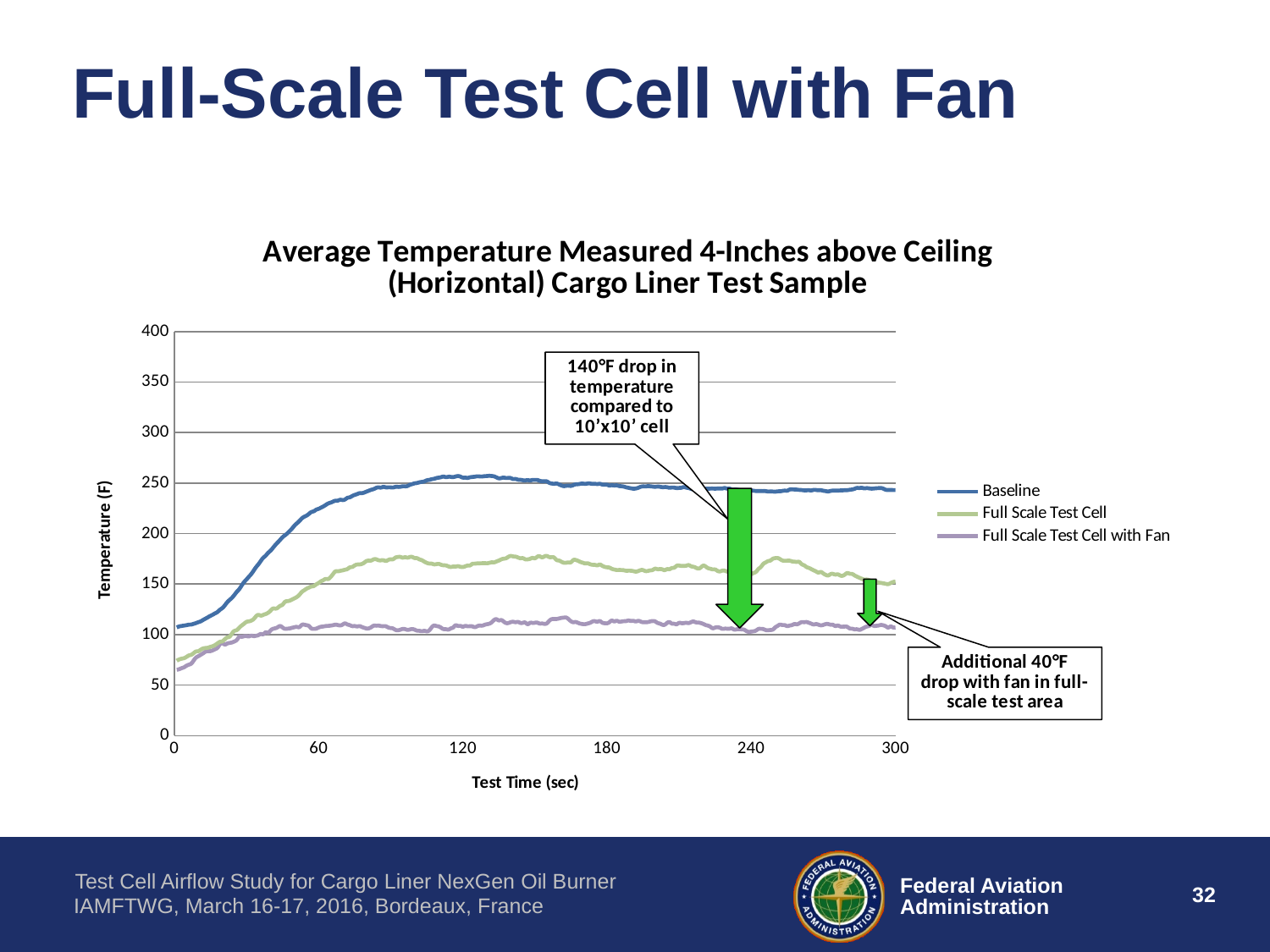
What is the label of the x axis? Test Time (sec) Which series has the highest temperature across the test? Baseline Is the Full Scale Test Cell with Fan temperature at 240 seconds greater or less than 150? less Does the Baseline temperature rise or fall between 0 and 60 seconds? rise Is the Full Scale Test Cell temperature at 120 seconds greater or less than 150? greater How many series does the legend list? 3 Is the Baseline temperature at 120 seconds greater or less than 200? greater At 180 seconds, which is larger: the Baseline temperature or the Full Scale Test Cell with Fan temperature? Baseline What is the title of the chart? Average Temperature Measured 4-Inches above Ceiling (Horizontal) Cargo Liner Test Sample Which series has the lowest temperature across the test? Full Scale Test Cell with Fan What kind of chart is shown on the slide? line chart